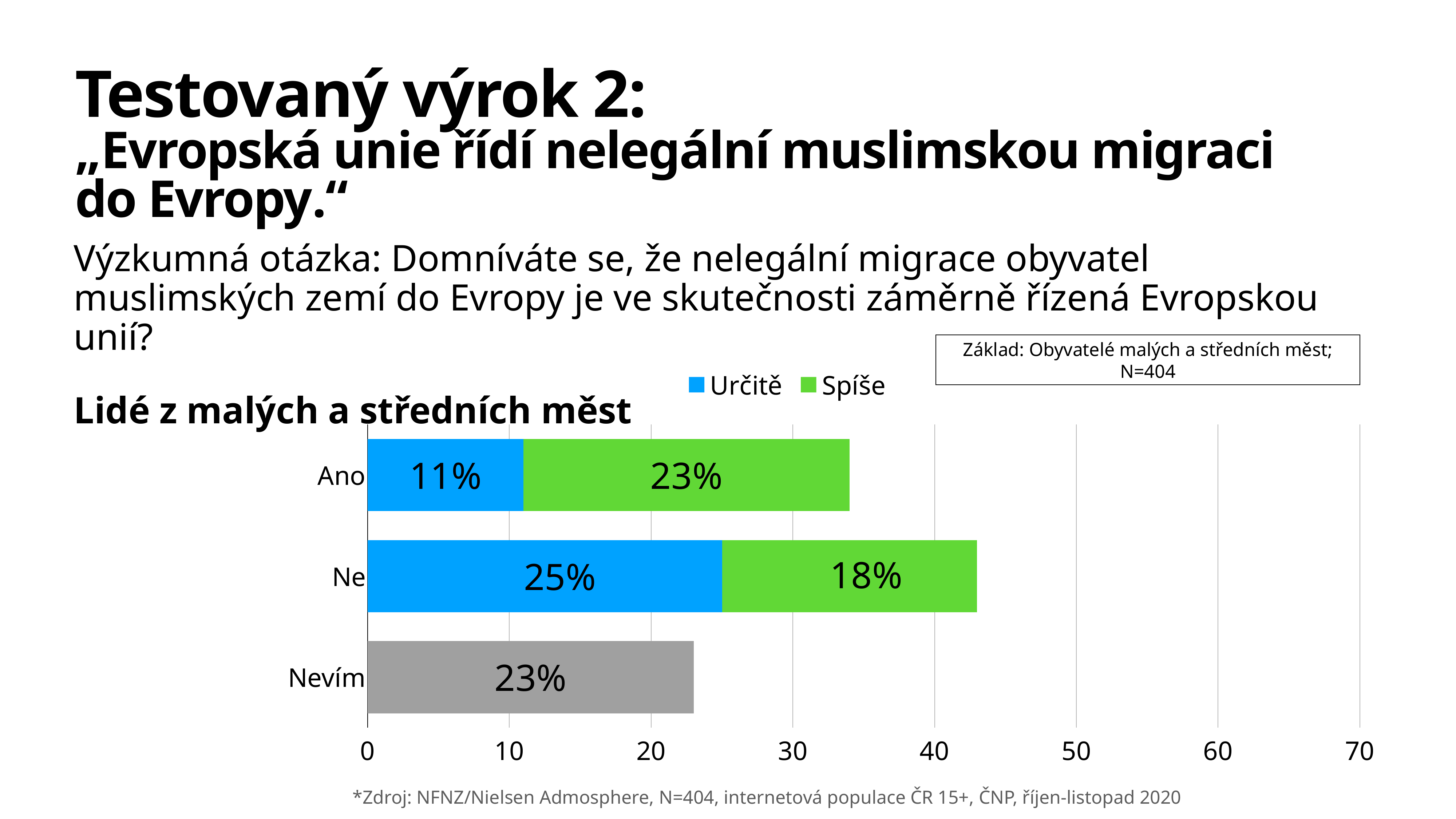
Which category has the lowest "Spíše" value? Ne Which is larger: the "Spíše" value for "Ano" or the "Spíše" value for "Ne"? Ano What is the "Spíše" value for "Ano"? 23% What is the difference between the "Určitě" values for "Ne" and "Ano"? 14% What is the "Určitě" value for "Ano"? 11% How many categories are shown on the y axis of the chart? 3 What is the total of the stacked bar for "Ne"? 43% Which category has the highest "Určitě" value? Ne What type of chart is shown on the slide? Stacked bar chart What value is shown for "Nevím"? 23% What is the "Spíše" value for "Ne"? 18% What is the total of the stacked bar for "Ano"? 34%